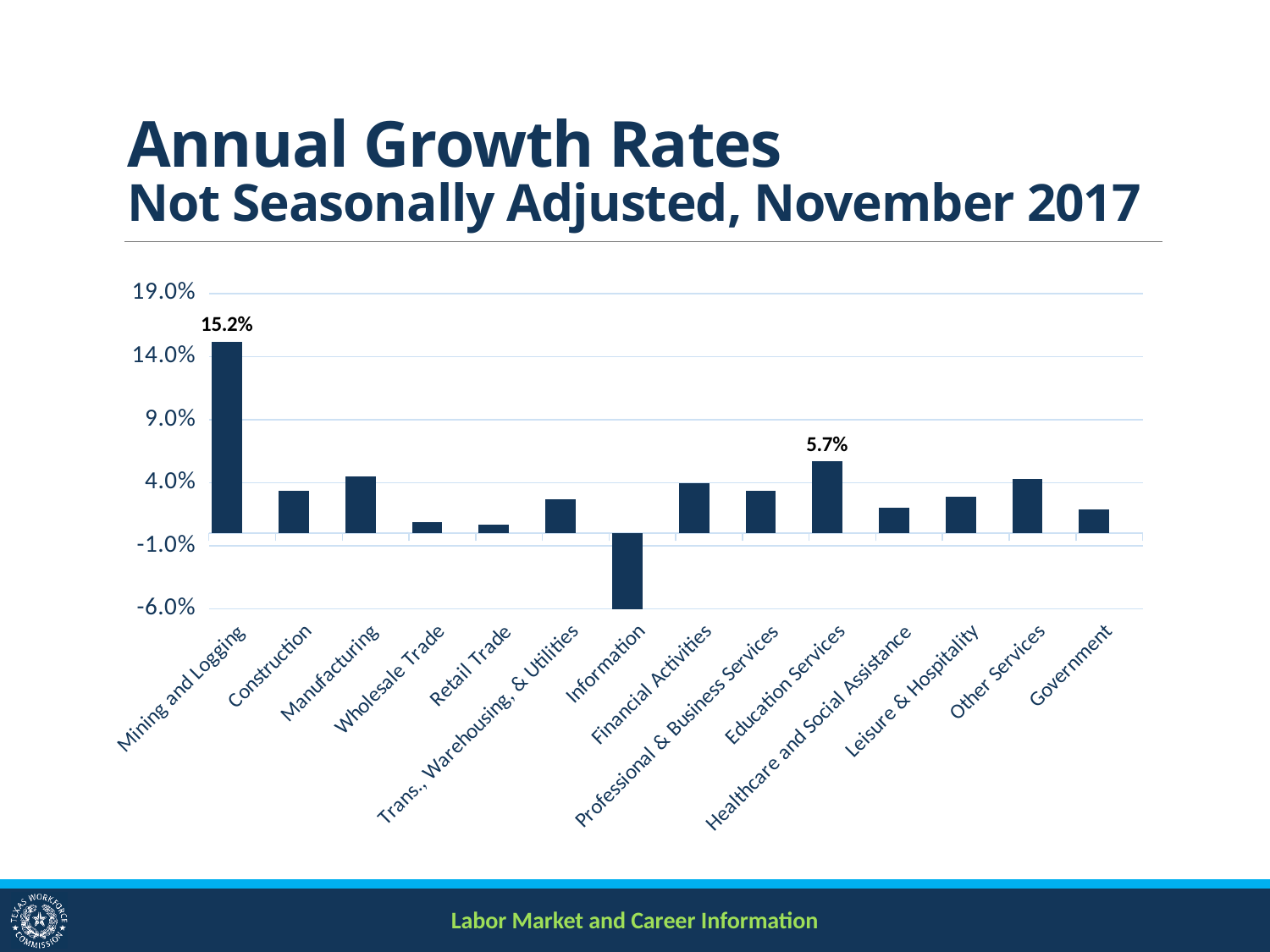
Which industry has the lowest annual growth rate? Information What is the subtitle of the chart on the slide? Not Seasonally Adjusted, November 2017 Which industry has the highest annual growth rate? Mining and Logging Is the value for Construction greater or less than 4.0%? less What is the annual growth rate for Education Services? 5.7% Which has a higher growth rate, Financial Activities or Wholesale Trade? Financial Activities What is the annual growth rate for Mining and Logging? 15.2% What is the difference between the growth rates of Mining and Logging and Education Services? 9.5 percentage points How many industries show a negative growth rate? 1 What type of chart is shown on the slide? Bar chart Is the value for Information greater or less than -1.0%? less How many industries are shown on the chart? 14